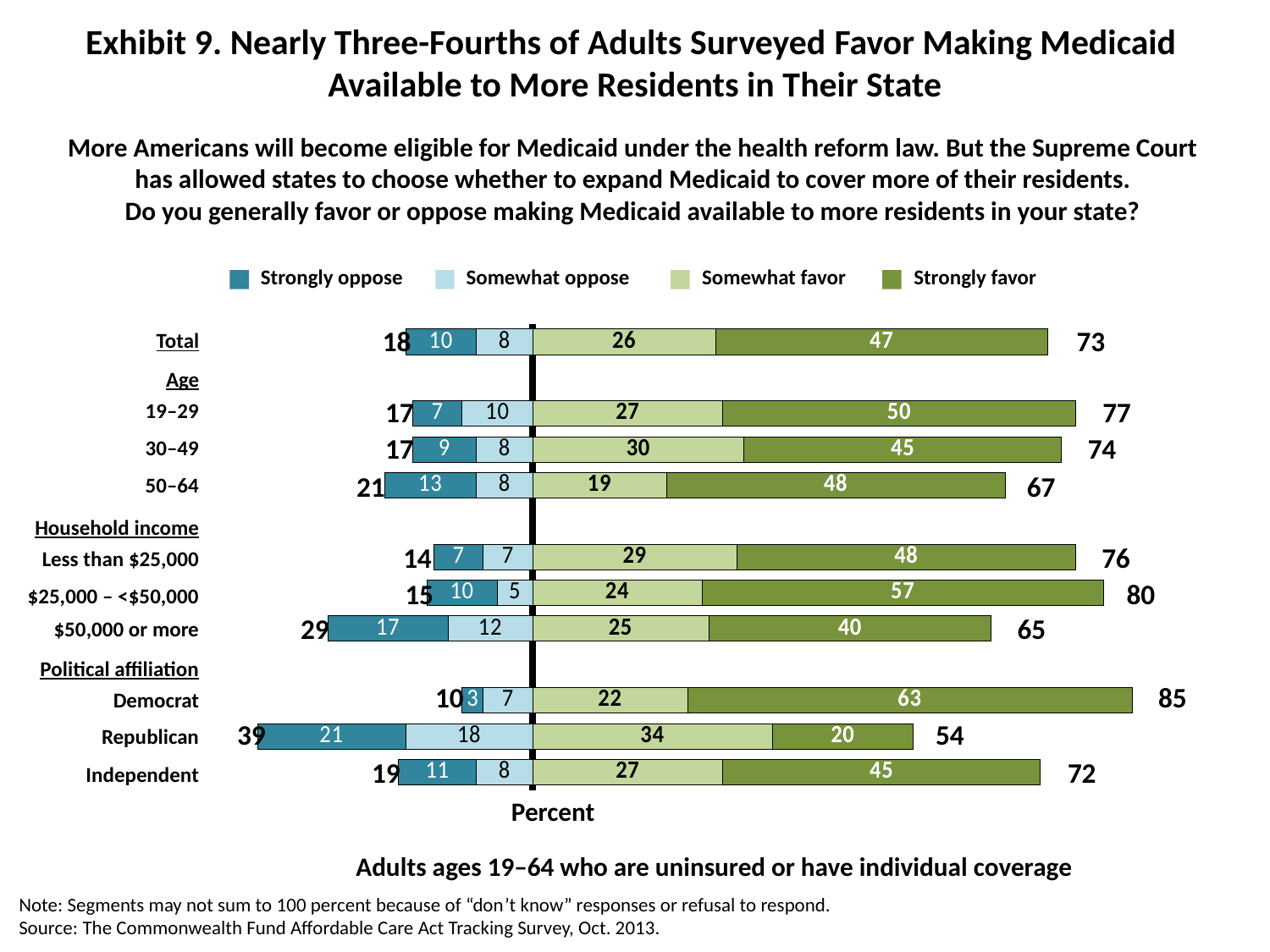
What is the combined oppose total (Strongly oppose plus Somewhat oppose) for the 50–64 age group? 21 Which group has the highest combined favor total (Somewhat favor plus Strongly favor)? Democrat What is the Strongly oppose value for the $50,000 or more household income group? 17 How many groups (bars) are plotted in the chart, including Total? 10 What is the label on the horizontal axis of the chart? Percent What is the Somewhat oppose value for Republicans? 18 What percentage of Democrats strongly favor making Medicaid available to more residents? 63 What kind of chart is shown on the slide? Stacked bar chart Which group has the lowest Strongly favor value? Republican What is the difference between the Strongly favor values for Democrats and Republicans? 43 How many series does the legend list? 4 Which is larger: the Somewhat favor value for 30–49 or for 50–64? 30–49